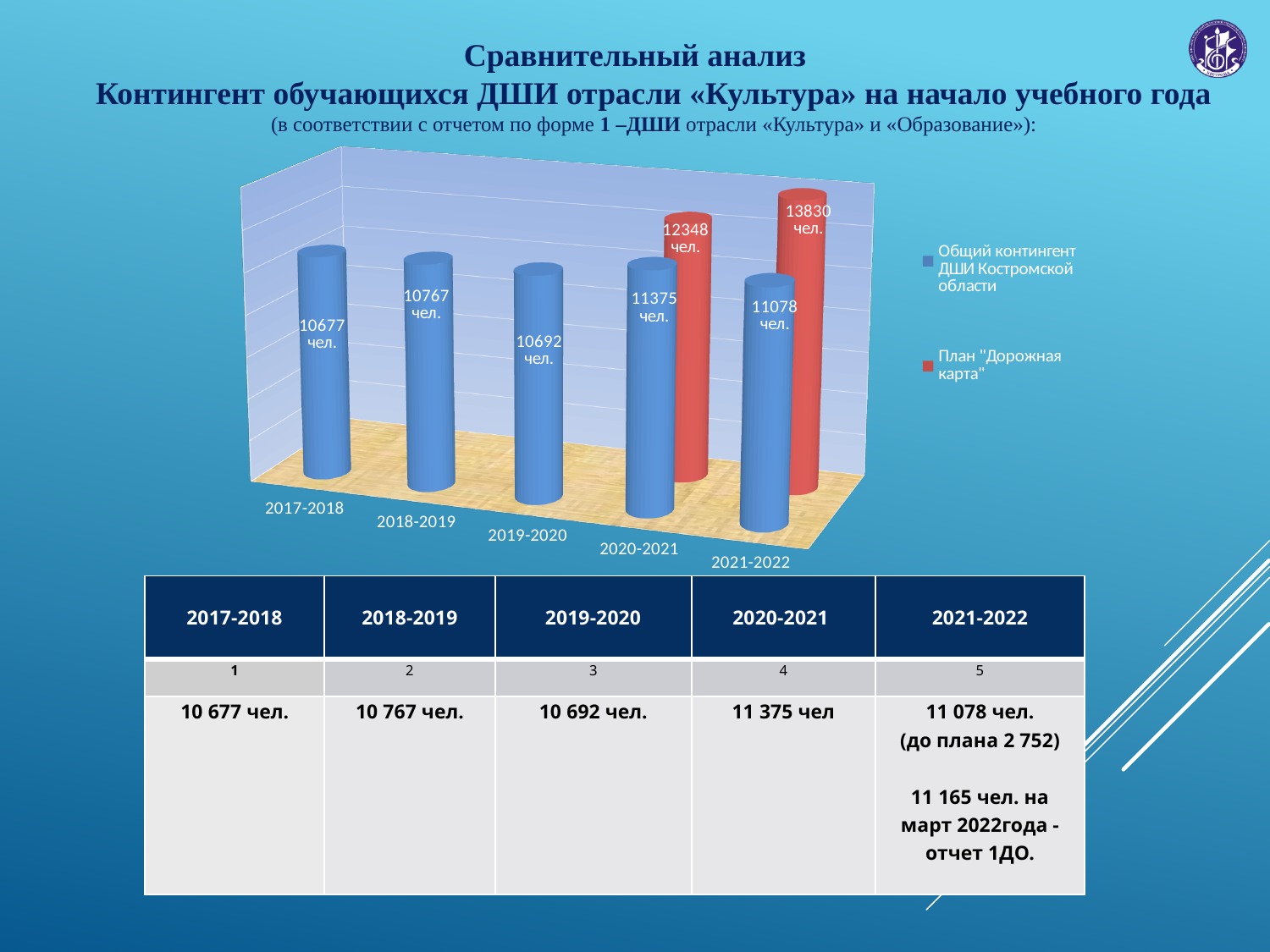
By how much does the "План "Дорожная карта"" value exceed the "Общий контингент" value in 2021-2022? 2752 чел. In which academic year is the "Общий контингент ДШИ Костромской области" value highest? 2020-2021 In which academic year is the "Общий контингент ДШИ Костромской области" value lowest? 2017-2018 By how much does the "План "Дорожная карта"" value exceed the "Общий контингент" value in 2020-2021? 973 чел. What is the value of the "Общий контингент ДШИ Костромской области" series for 2019-2020? 10692 чел. What is the value of the "План "Дорожная карта"" series for 2021-2022? 13830 чел. How many academic years are shown on the x axis of the chart? 5 What kind of chart is shown on the slide? Bar chart Which year has the larger "Общий контингент ДШИ Костромской области" value, 2020-2021 or 2021-2022? 2020-2021 How many series does the chart legend list? 2 Does the "План "Дорожная карта"" value rise or fall from 2020-2021 to 2021-2022? Rises What is the value of the "Общий контингент ДШИ Костромской области" series for 2017-2018? 10677 чел.